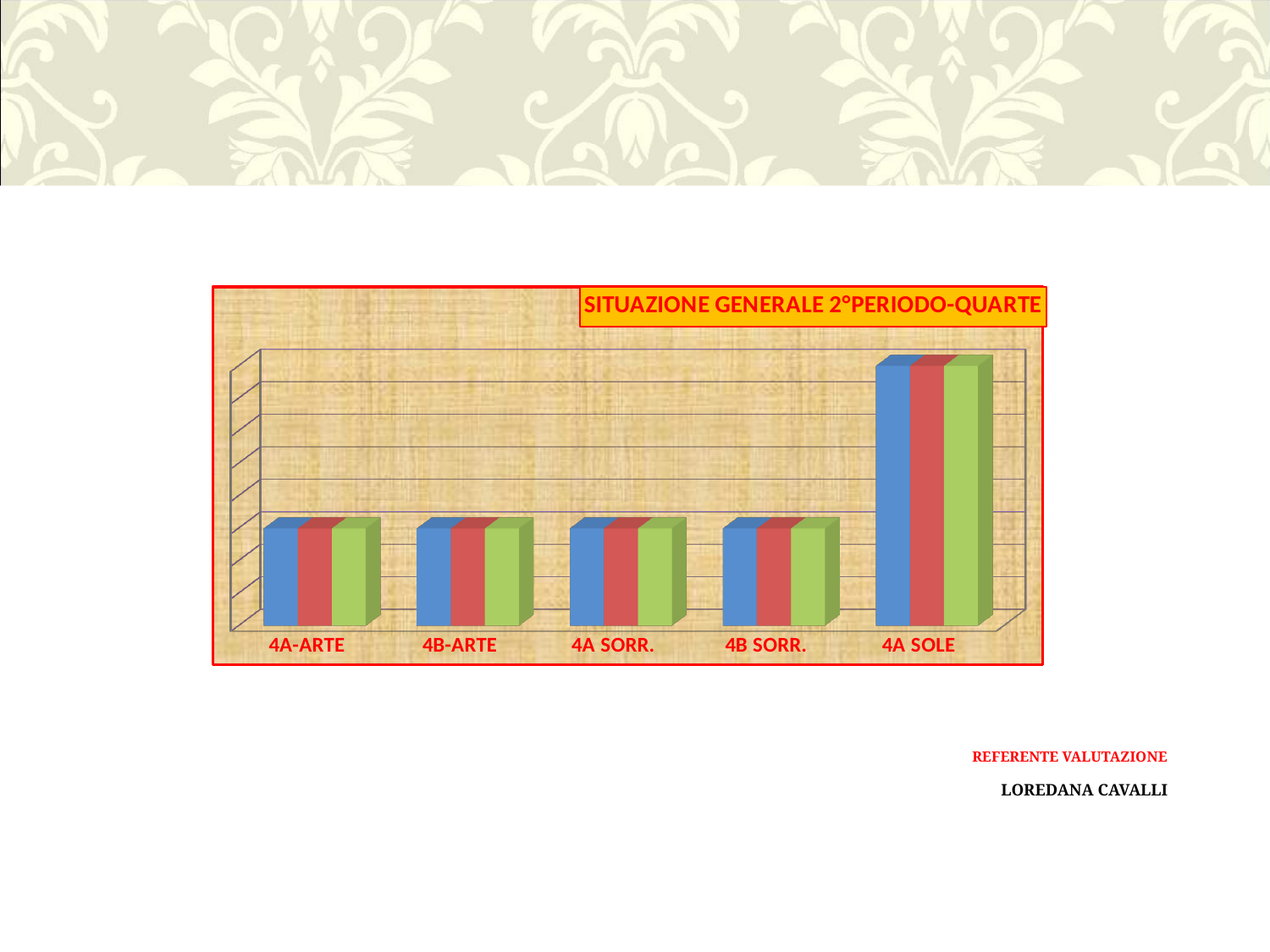
What kind of chart is shown on the slide? bar chart How many categories are shown on the x axis of the chart? 5 Which category has larger values, 4B SORR. or 4A SOLE? 4A SOLE Which category has the highest bars in the chart? 4A SOLE Which category has larger values, 4A SOLE or 4A-ARTE? 4A SOLE What is the title of the chart? SITUAZIONE GENERALE 2°PERIODO-QUARTE How many bars are plotted for each category in the chart? 3 What is the label of the first category on the x axis? 4A-ARTE What is the label of the last category on the x axis? 4A SOLE